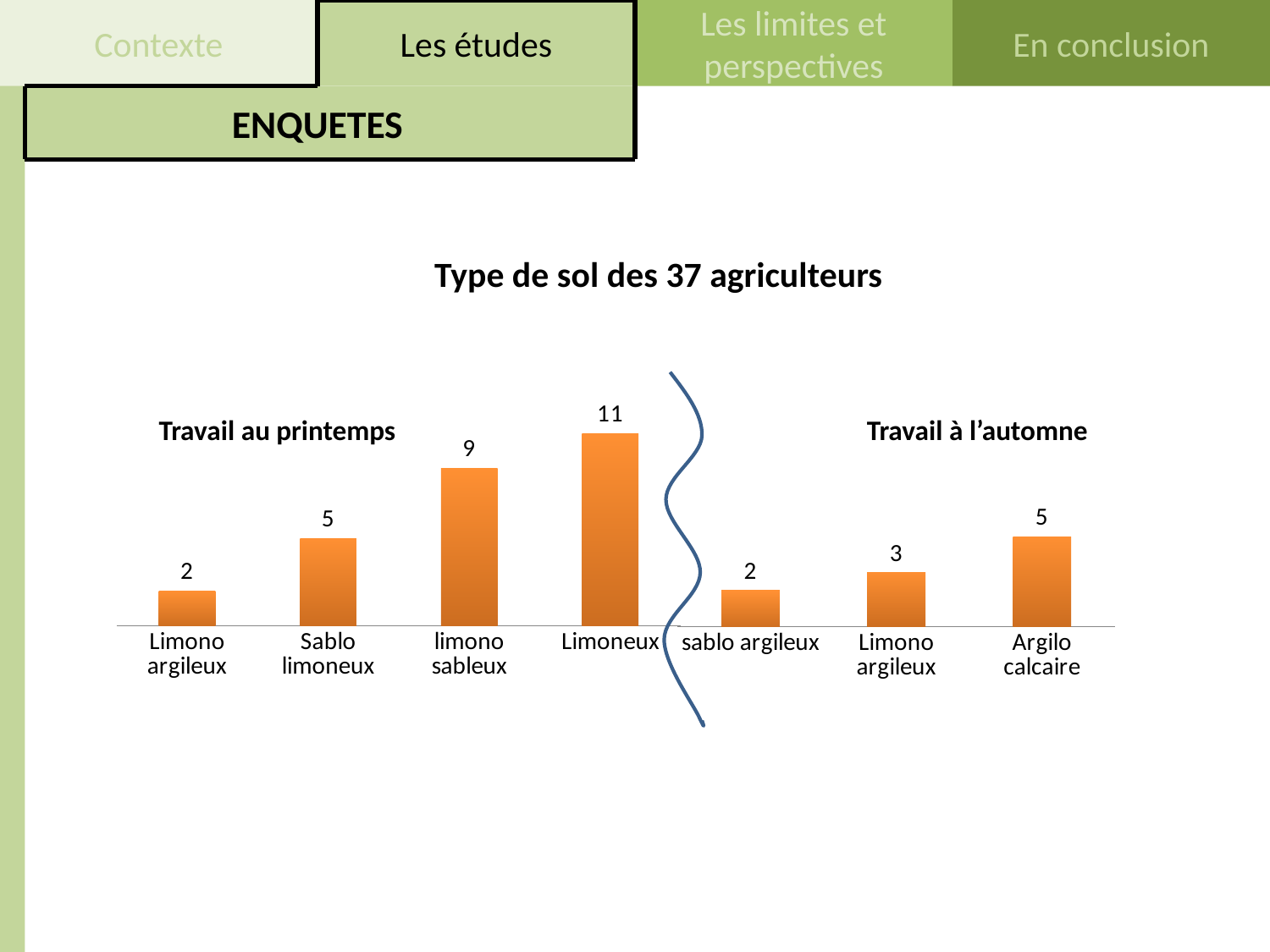
What is the title of the chart? Type de sol des 37 agriculteurs What is the total of the four bars in the 'Travail au printemps' section? 27 How many bars does the chart have? 7 What is the value for Limoneux? 11 What is the value for Limono argileux in the 'Travail à l'automne' section? 3 Do the values rise or fall from Limono argileux to Limoneux in the 'Travail au printemps' section? rise What kind of chart is shown on the slide? bar chart Which category has the highest value? Limoneux Which is larger, the value for Sablo limoneux or the value for sablo argileux? Sablo limoneux What is the value for limono sableux? 9 What is the value for Argilo calcaire? 5 What is the difference between the values for Limoneux and limono sableux? 2